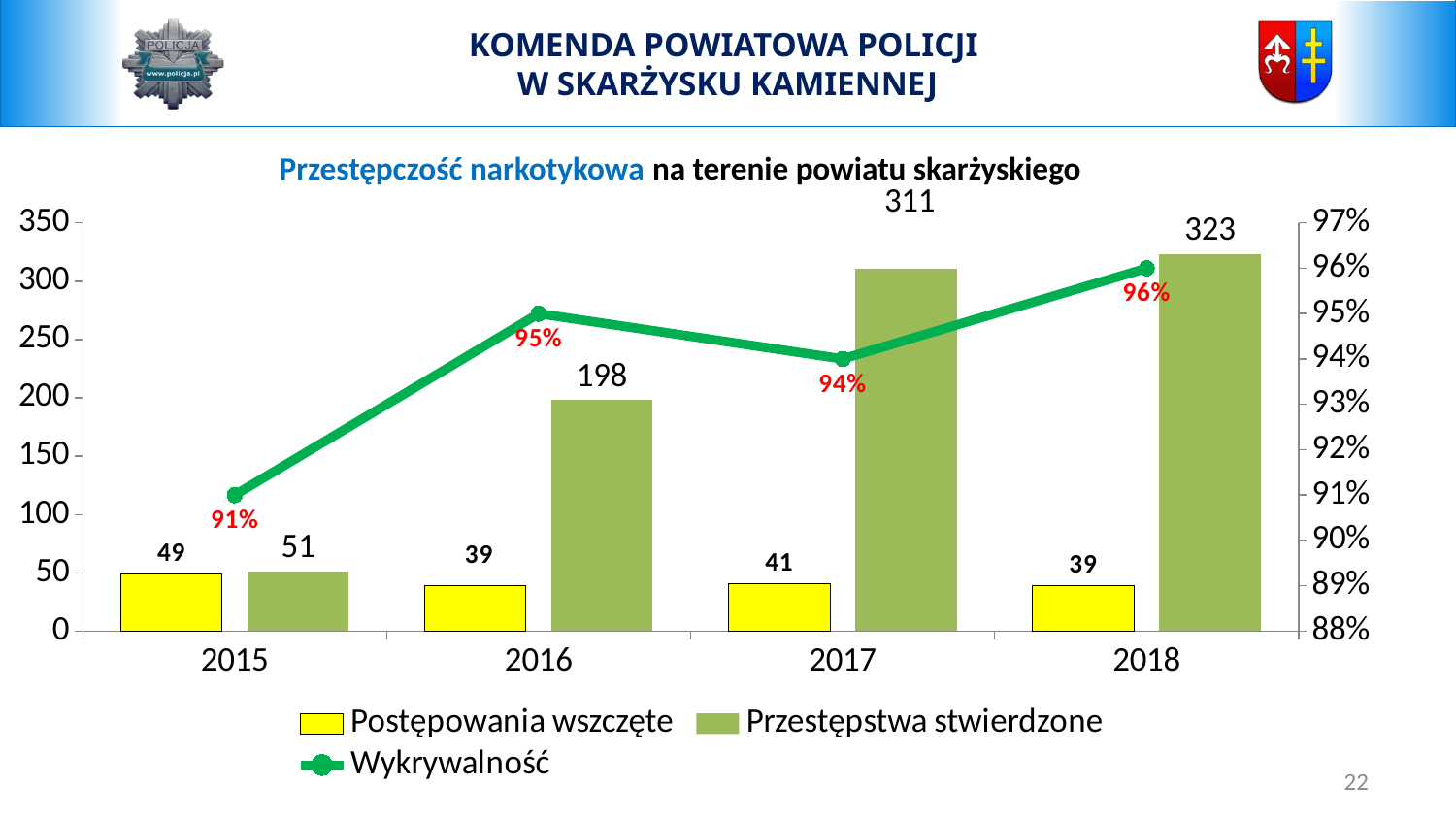
Is the value for Przestępstwa stwierdzone in 2016 greater or less than 150? greater What is the value of Przestępstwa stwierdzone in 2017? 311 How many years are shown on the x axis? 4 In which year is Przestępstwa stwierdzone highest? 2018 What is the difference between Przestępstwa stwierdzone in 2018 and in 2015? 272 How many series does the legend list? 3 What is the value of Postępowania wszczęte in 2015? 49 What kind of chart is used for Wykrywalność? line chart Does Przestępstwa stwierdzone rise or fall from 2015 to 2018? rise In which year is Wykrywalność lowest? 2015 Which is larger: Postępowania wszczęte in 2017 or in 2016? 2017 What is the Wykrywalność value for 2016? 95%